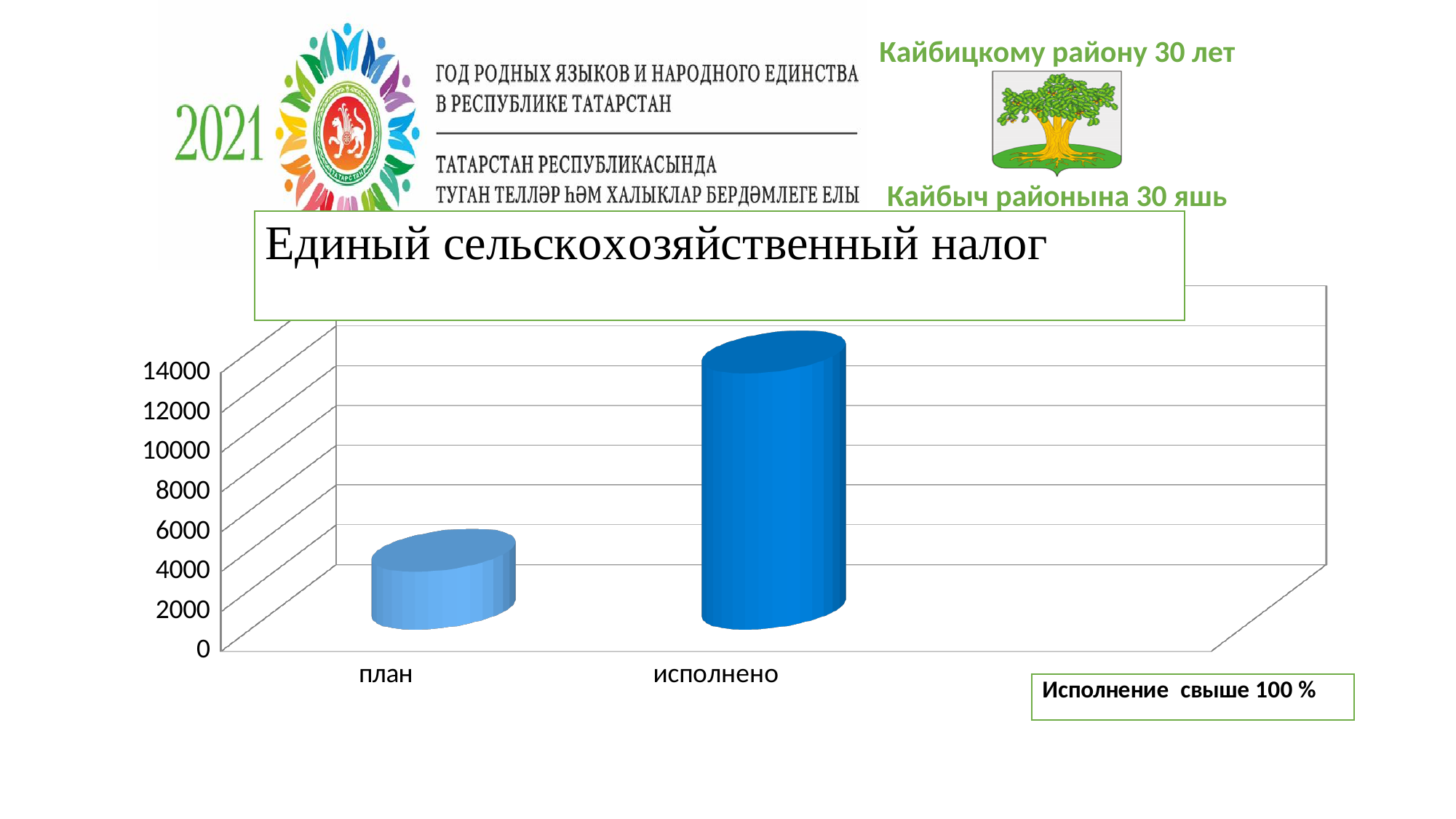
What is the title of the chart? Единый сельскохозяйственный налог Which category has the lowest value in the chart? план Is the value for план greater or less than 6000? less What is the highest tick value shown on the vertical axis of the chart? 14000 Which is larger, the value for план or the value for исполнено? исполнено Is the value for исполнено greater or less than 10000? greater Do the values rise or fall from план to исполнено along the x axis? rise Is the value for план greater or less than 2000? greater What type of chart is shown on the slide? bar chart Which category has the highest value in the chart? исполнено How many categories are shown on the x axis of the chart? 2